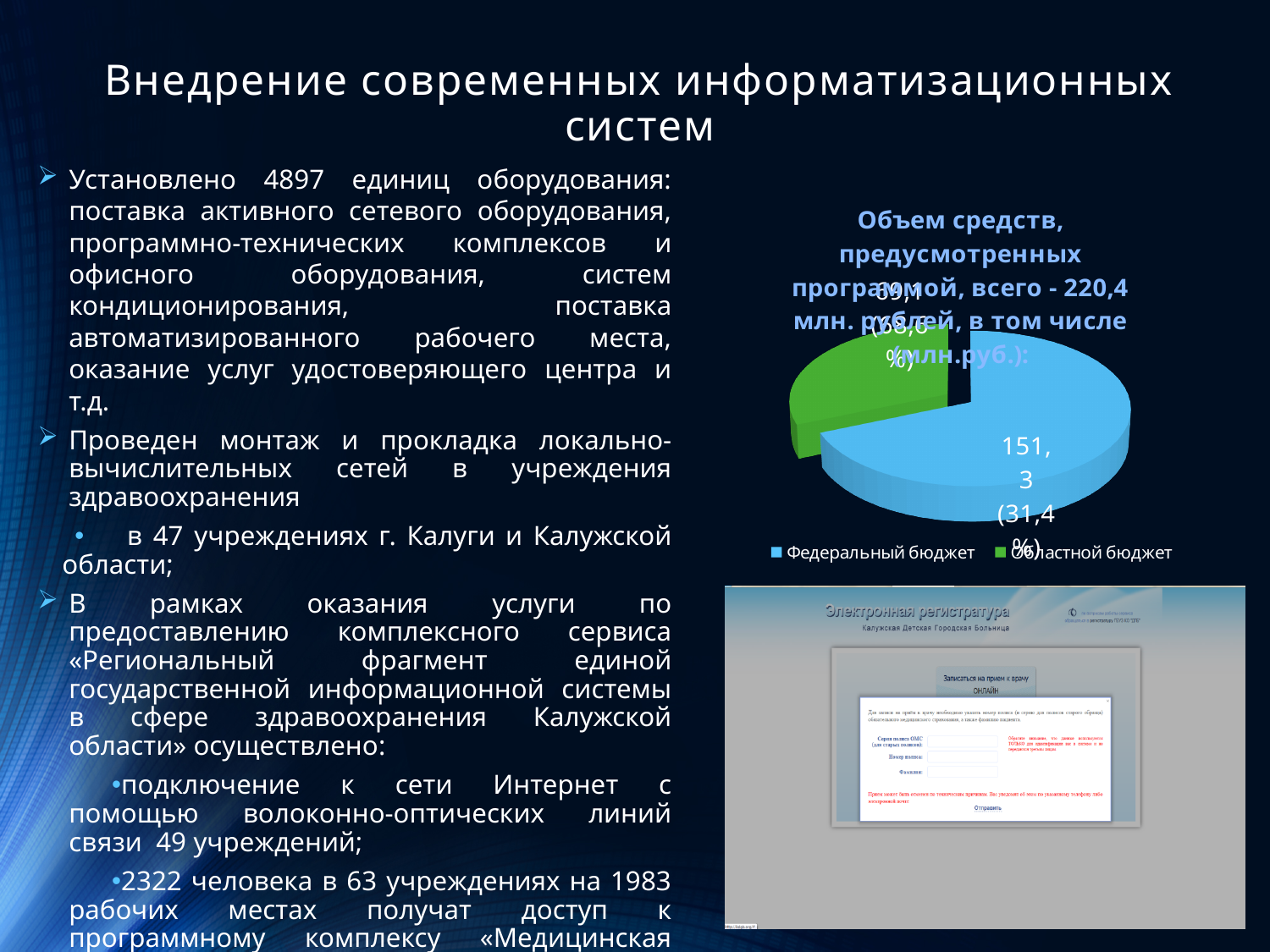
Which budget source has the larger slice in the pie chart? Федеральный бюджет Is the value for Федеральный бюджет larger or smaller than the value for Областной бюджет? Larger How many entries does the legend of the pie chart list? 2 Which budget source has the smaller slice in the pie chart? Областной бюджет According to the chart title, what is the total amount of funds provided by the programme? 220,4 млн. рублей What is the difference between the Федеральный бюджет value and the Областной бюджет value in the pie chart? 82,2 How many slices does the pie chart have? 2 Which colour represents Областной бюджет in the pie chart? Green What value is shown for Областной бюджет in the pie chart? 69,1 What kind of chart is shown on the slide? Pie chart What value is shown for Федеральный бюджет in the pie chart? 151,3 What is the total of the two values shown in the pie chart? 220,4